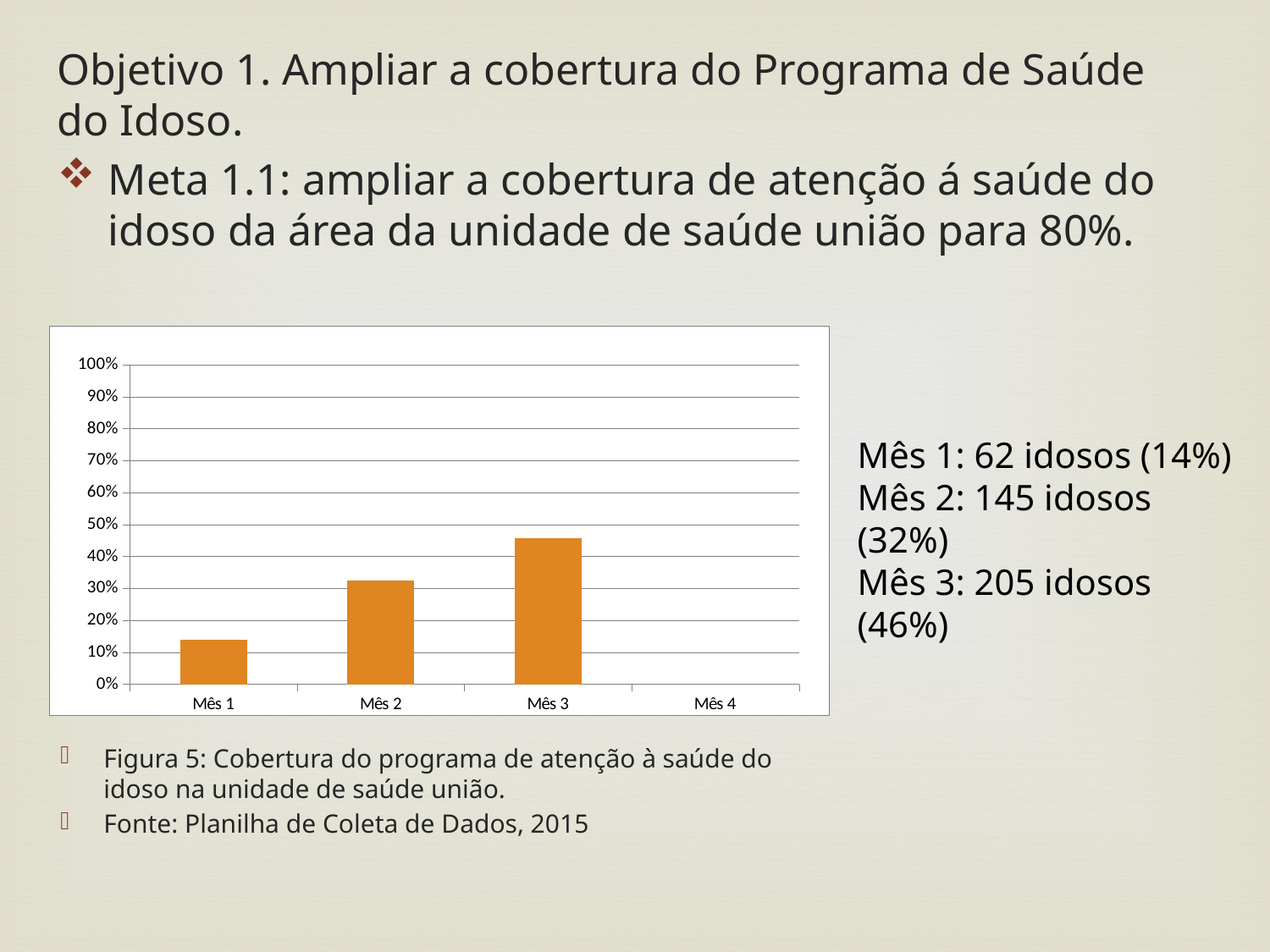
How many categories are shown on the x axis of the chart? 4 Is the value for Mês 2 greater or less than 30%? greater According to the slide, what coverage percentage corresponds to Mês 3? 46% Which is larger, the value for Mês 2 or the value for Mês 3? Mês 3 Is the value for Mês 3 greater or less than 40%? greater Among the months with a visible bar, which has the lowest value? Mês 1 Which month has the highest bar in the chart? Mês 3 Is the value for Mês 1 greater or less than 20%? less Do the values rise or fall from Mês 1 to Mês 3? rise According to the slide, what coverage percentage corresponds to Mês 2? 32% What kind of chart is shown on the slide? bar chart What is the highest value shown on the y axis of the chart? 100%